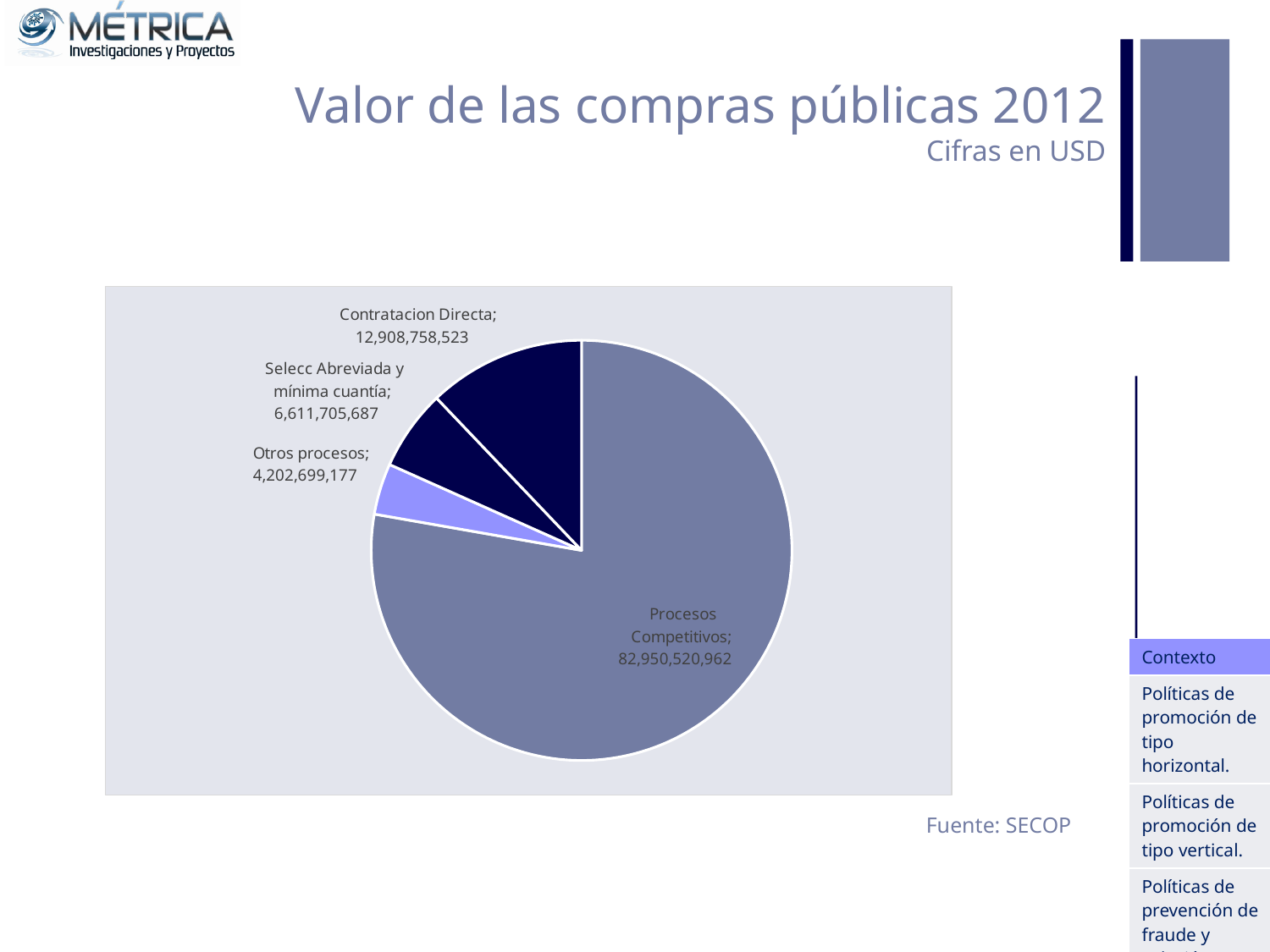
Which is larger, Contratacion Directa or Otros procesos? Contratacion Directa Which category has the smallest slice of the pie? Otros procesos What is the value for Procesos Competitivos? 82,950,520,962 How many slices does the pie chart have? 4 Which category has the largest slice of the pie? Procesos Competitivos What is the value for Otros procesos? 4,202,699,177 What is the difference between Selecc Abreviada y mínima cuantía and Otros procesos? 2,409,006,510 What type of chart is shown on the slide? Pie chart What is the value for Selecc Abreviada y mínima cuantía? 6,611,705,687 What is the difference between Contratacion Directa and Selecc Abreviada y mínima cuantía? 6,297,052,836 What is the value for Contratacion Directa? 12,908,758,523 What is the title of the chart on the slide? Valor de las compras públicas 2012